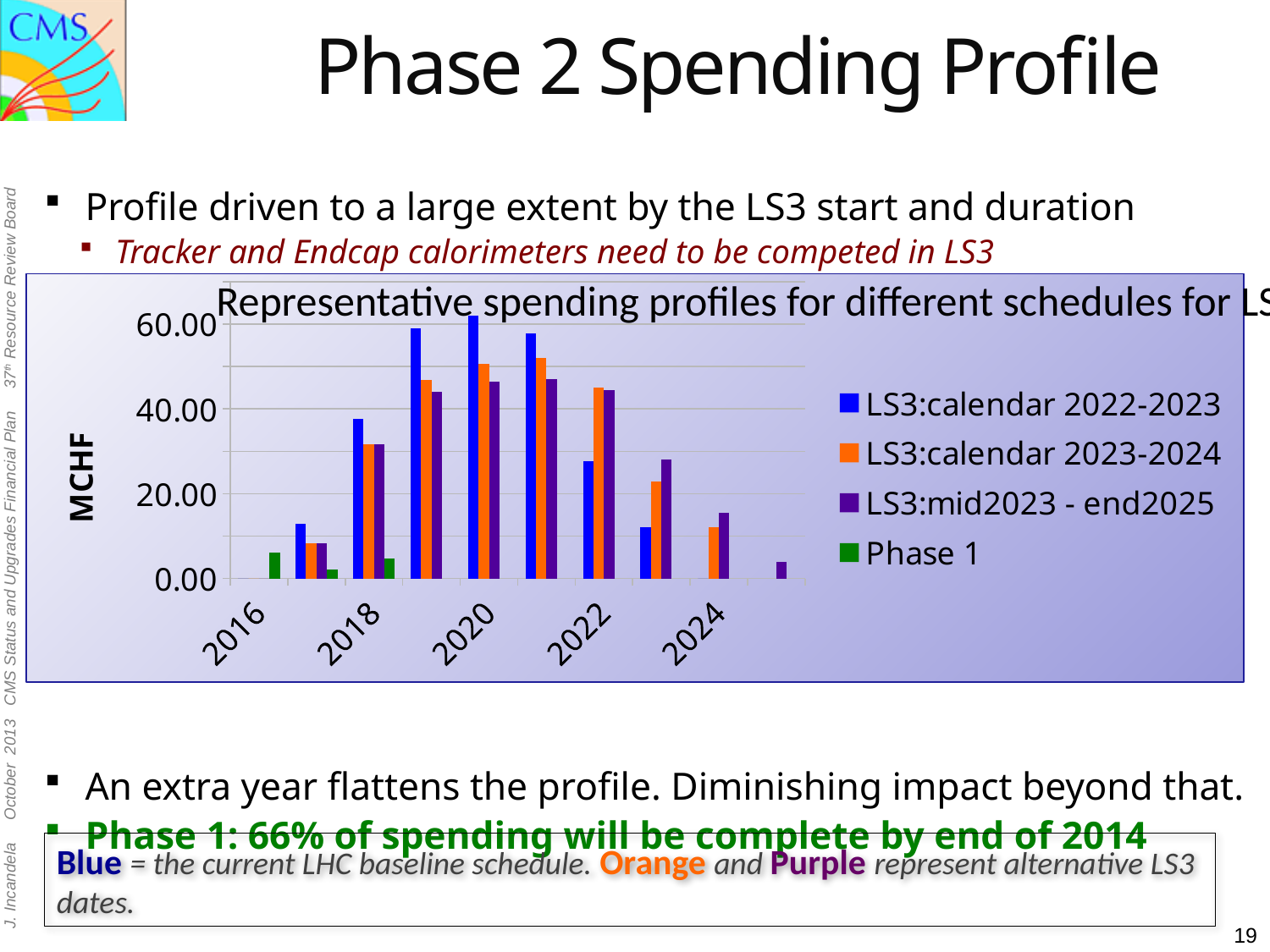
In 2023, which is larger: LS3:calendar 2023-2024 or LS3:mid2023 - end2025? LS3:mid2023 - end2025 Is the value for LS3:calendar 2022-2023 in 2022 greater or less than 20.00? greater Which legend entry is shown in green? Phase 1 Is the value for LS3:calendar 2023-2024 in 2020 greater or less than 40.00? greater Is the value for Phase 1 in 2016 greater or less than 20.00? less How many series does the chart legend list? 4 Which series is the only one with a bar plotted in 2016? Phase 1 What is the label on the vertical axis of the chart? MCHF What kind of chart is shown on the slide? bar chart Do the values for LS3:calendar 2022-2023 rise or fall from 2020 to 2023? fall In 2019, which is larger: LS3:calendar 2022-2023 or LS3:calendar 2023-2024? LS3:calendar 2022-2023